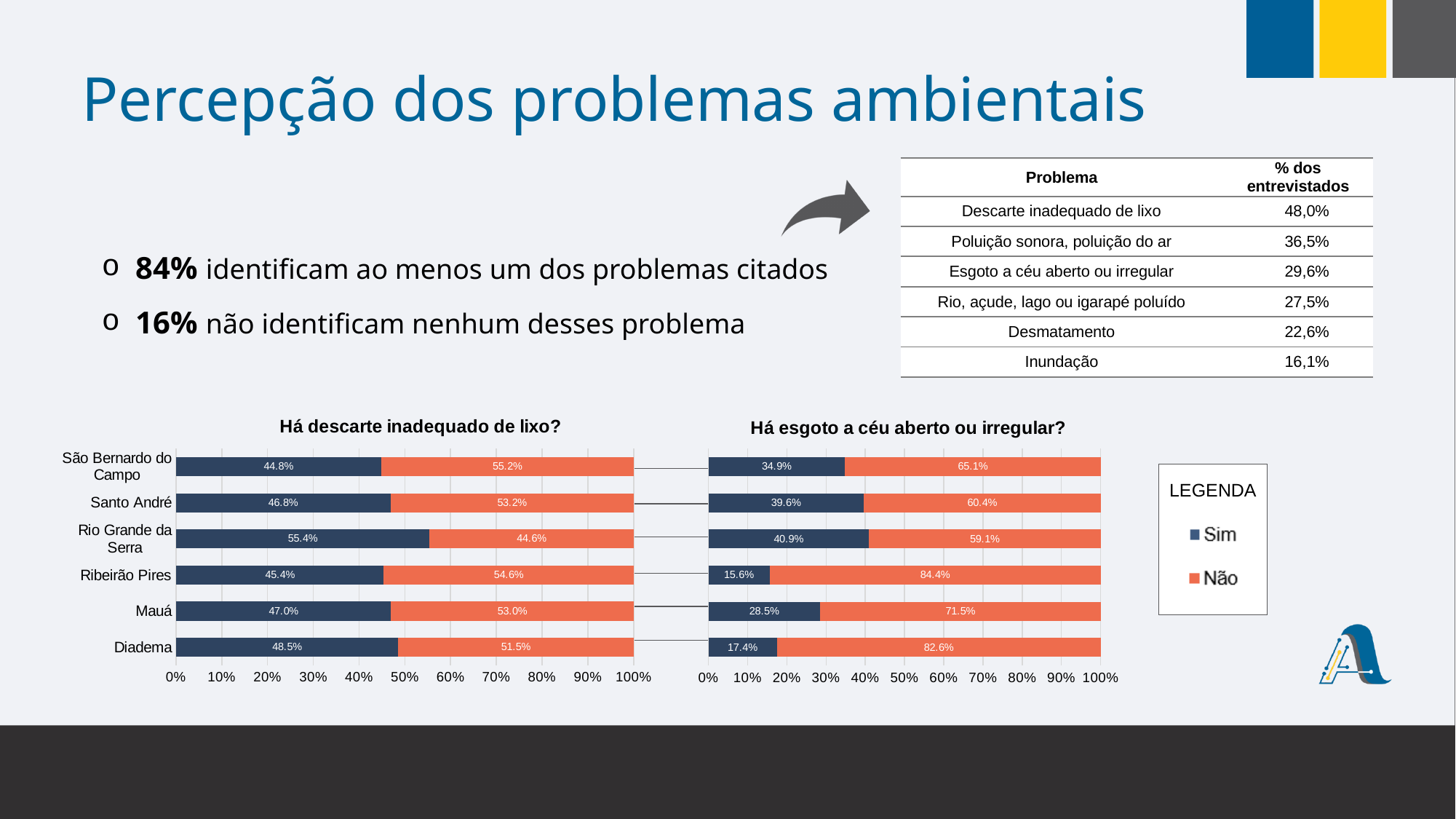
In the chart 'Há esgoto a céu aberto ou irregular?', what is the total of the 'Sim' and 'Não' values for São Bernardo do Campo? 100% In the chart 'Há esgoto a céu aberto ou irregular?', which city has the lowest 'Sim' value? Ribeirão Pires In the chart 'Há descarte inadequado de lixo?', which city has the lowest 'Sim' value? São Bernardo do Campo How many cities are shown in the chart 'Há esgoto a céu aberto ou irregular?'? 6 How many series does the legend list for the two bar charts? 2 In the chart 'Há descarte inadequado de lixo?', is the 'Sim' value for Santo André greater or less than 50%? less What kind of chart is 'Há descarte inadequado de lixo?'? Stacked bar chart In the chart 'Há esgoto a céu aberto ou irregular?', what is the 'Não' value for Ribeirão Pires? 84.4% In the chart 'Há descarte inadequado de lixo?', what is the 'Sim' value for Rio Grande da Serra? 55.4% In the chart 'Há descarte inadequado de lixo?', what is the difference between the 'Não' and 'Sim' values for Diadema? 3.0% In the chart 'Há esgoto a céu aberto ou irregular?', which city has the highest 'Sim' value? Rio Grande da Serra In the chart 'Há esgoto a céu aberto ou irregular?', is the 'Sim' value larger for Mauá or for Diadema? Mauá